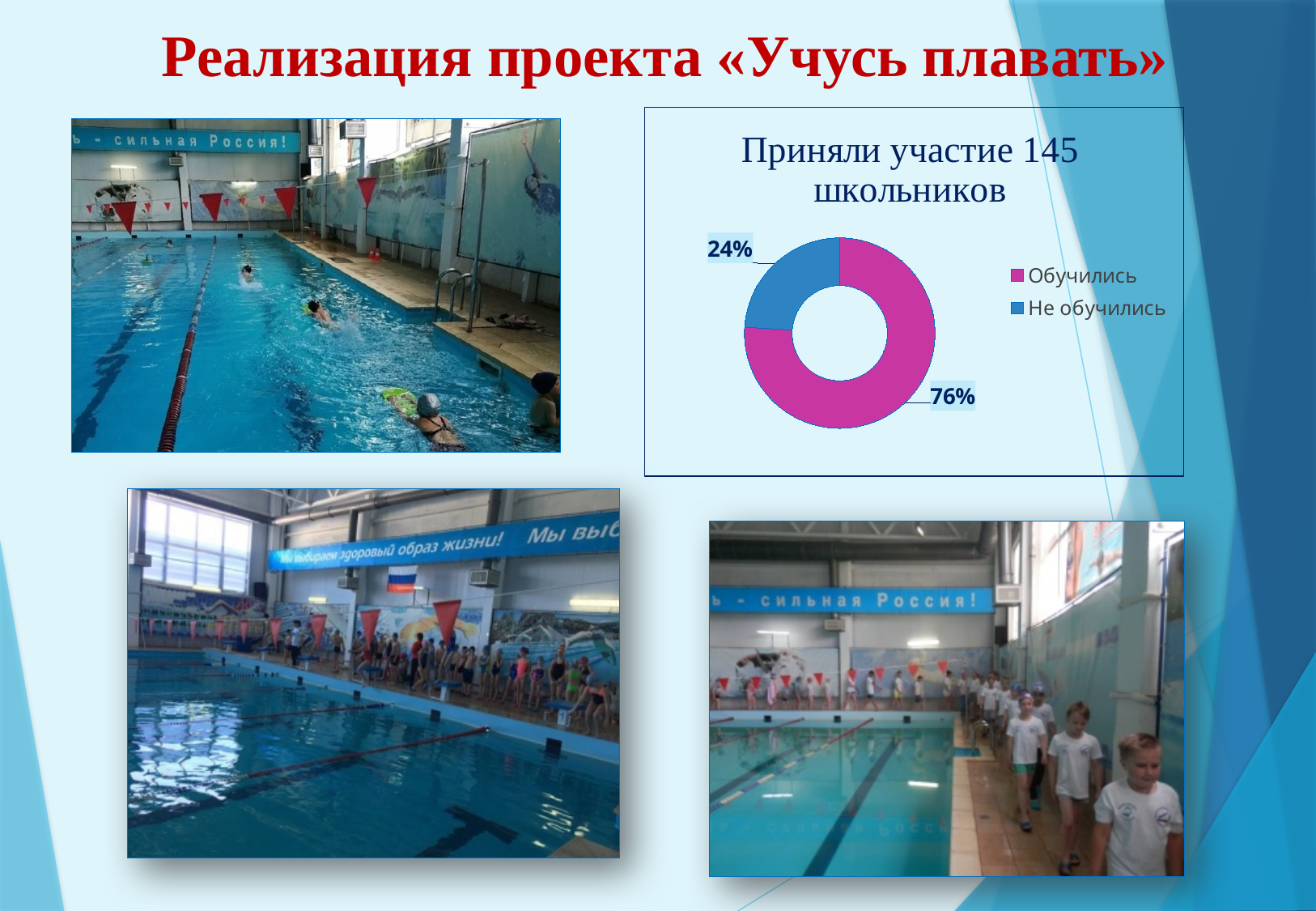
What is the title of the chart? Приняли участие 145 школьников What kind of chart is shown on the slide? Pie chart (doughnut) What colour is the "Не обучились" slice of the chart? Blue How many categories does the pie chart show? 2 What percentage of the pie chart is labelled "Не обучились"? 24% What is the difference in percentage points between the "Обучились" and "Не обучились" slices? 52 What percentage of the pie chart is labelled "Обучились"? 76% Which category has the largest share of the pie chart? Обучились Which category has the smallest share of the pie chart? Не обучились Which slice is larger, "Обучились" or "Не обучились"? Обучились How many schoolchildren took part according to the chart title? 145 How many entries does the chart legend list? 2